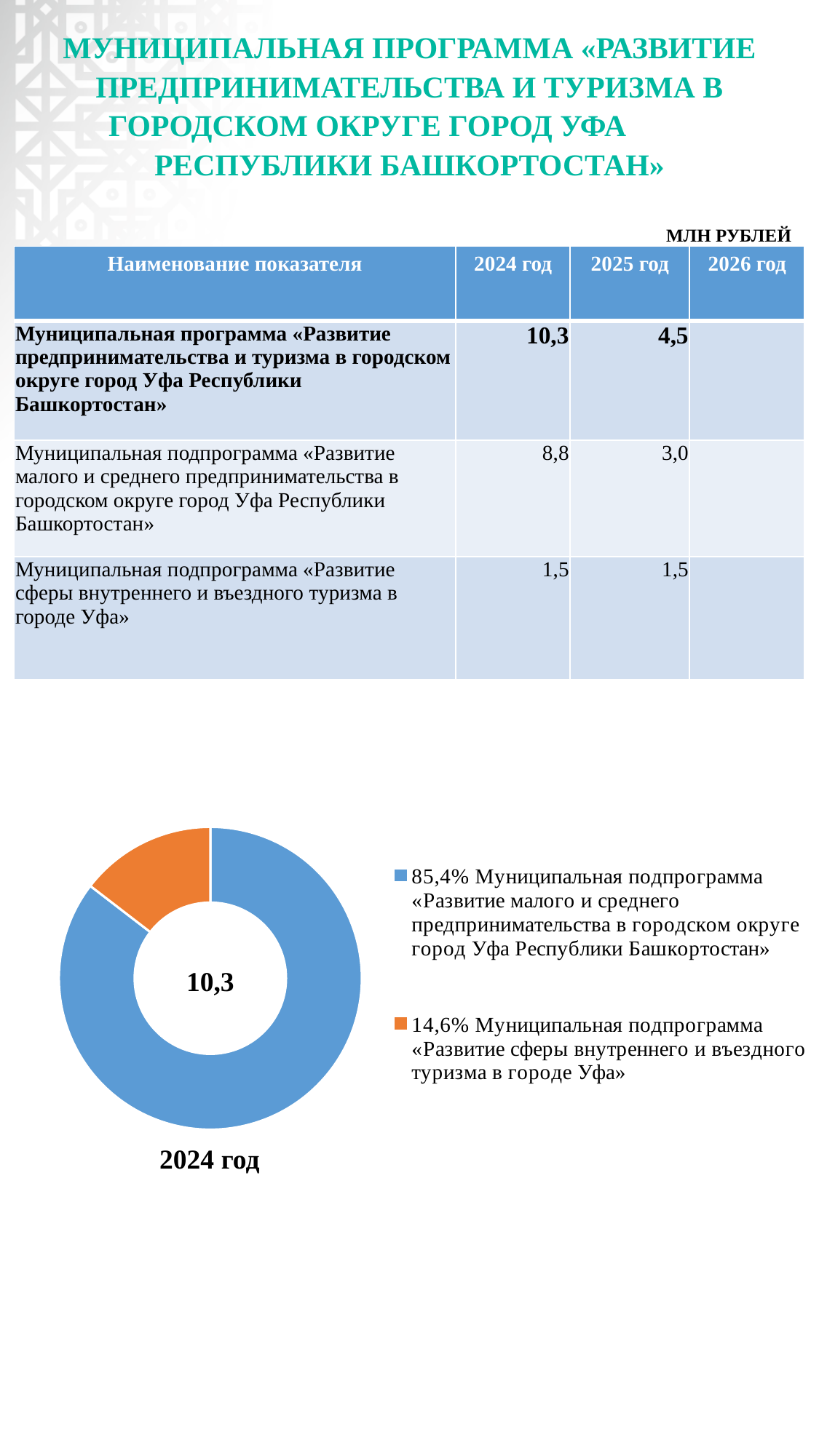
How many slices does the doughnut chart have? 2 Which subprogramme has the largest slice in the doughnut chart? «Развитие малого и среднего предпринимательства в городском округе город Уфа Республики Башкортостан» Is the share of the tourism subprogramme in the doughnut chart greater or less than 50%? less How many entries does the legend of the doughnut chart list? 2 Which subprogramme has the smallest slice in the doughnut chart? «Развитие сферы внутреннего и въездного туризма в городе Уфа» Which year is the doughnut chart labelled with? 2024 год By how many percentage points does the small and medium business slice exceed the tourism slice in the doughnut chart? 70,8 In the doughnut chart, which slice is larger: the small and medium business subprogramme or the tourism subprogramme? The small and medium business subprogramme What share of the doughnut chart is taken by the subprogramme «Развитие сферы внутреннего и въездного туризма в городе Уфа»? 14,6% What kind of chart is shown at the bottom of the slide? Doughnut (pie) chart What value is printed in the centre of the doughnut chart? 10,3 What share of the doughnut chart is taken by the subprogramme «Развитие малого и среднего предпринимательства в городском округе город Уфа Республики Башкортостан»? 85,4%